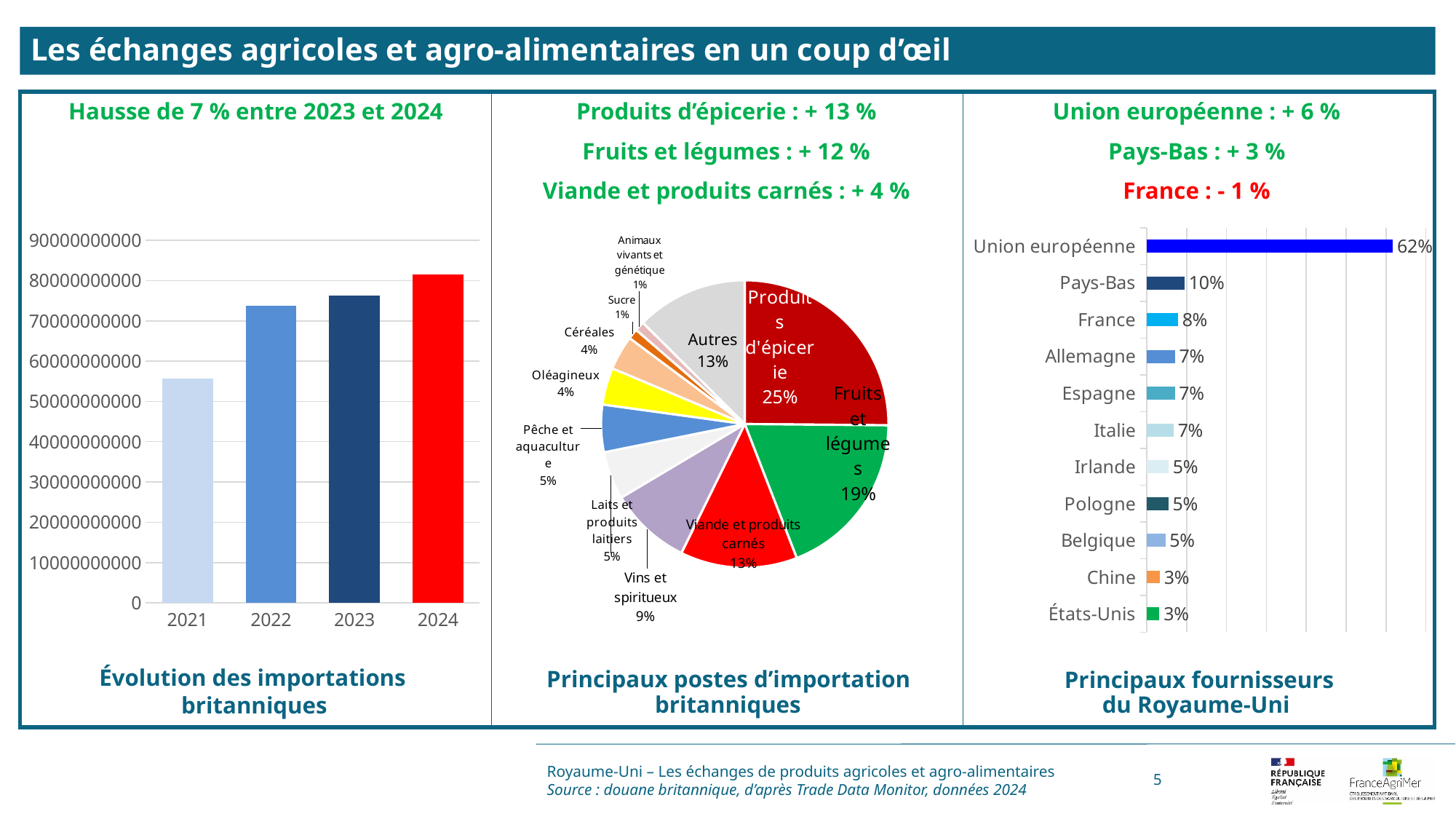
On the chart 'Évolution des importations britanniques', which year has the highest value? 2024 On the chart 'Principaux fournisseurs du Royaume-Uni', what is the value for France? 8% On the chart 'Évolution des importations britanniques', is the value for 2022 greater or less than 70000000000? greater On the chart 'Évolution des importations britanniques', do the values rise or fall from 2021 to 2024? rise On the chart 'Principaux fournisseurs du Royaume-Uni', which is larger, Pays-Bas or Chine? Pays-Bas On the pie chart 'Principaux postes d'importation britanniques', what is the difference in percentage points between 'Produits d'épicerie' and 'Fruits et légumes'? 6 On the chart 'Évolution des importations britanniques', is the value for 2021 greater or less than 60000000000? less On the pie chart 'Principaux postes d'importation britanniques', what share does 'Vins et spiritueux' have? 9% On the chart 'Évolution des importations britanniques', how many years are plotted? 4 On the pie chart 'Principaux postes d'importation britanniques', which category has the largest share? Produits d'épicerie On the chart 'Évolution des importations britanniques', what kind of chart is shown? bar chart On the chart 'Principaux fournisseurs du Royaume-Uni', how many suppliers are listed? 11